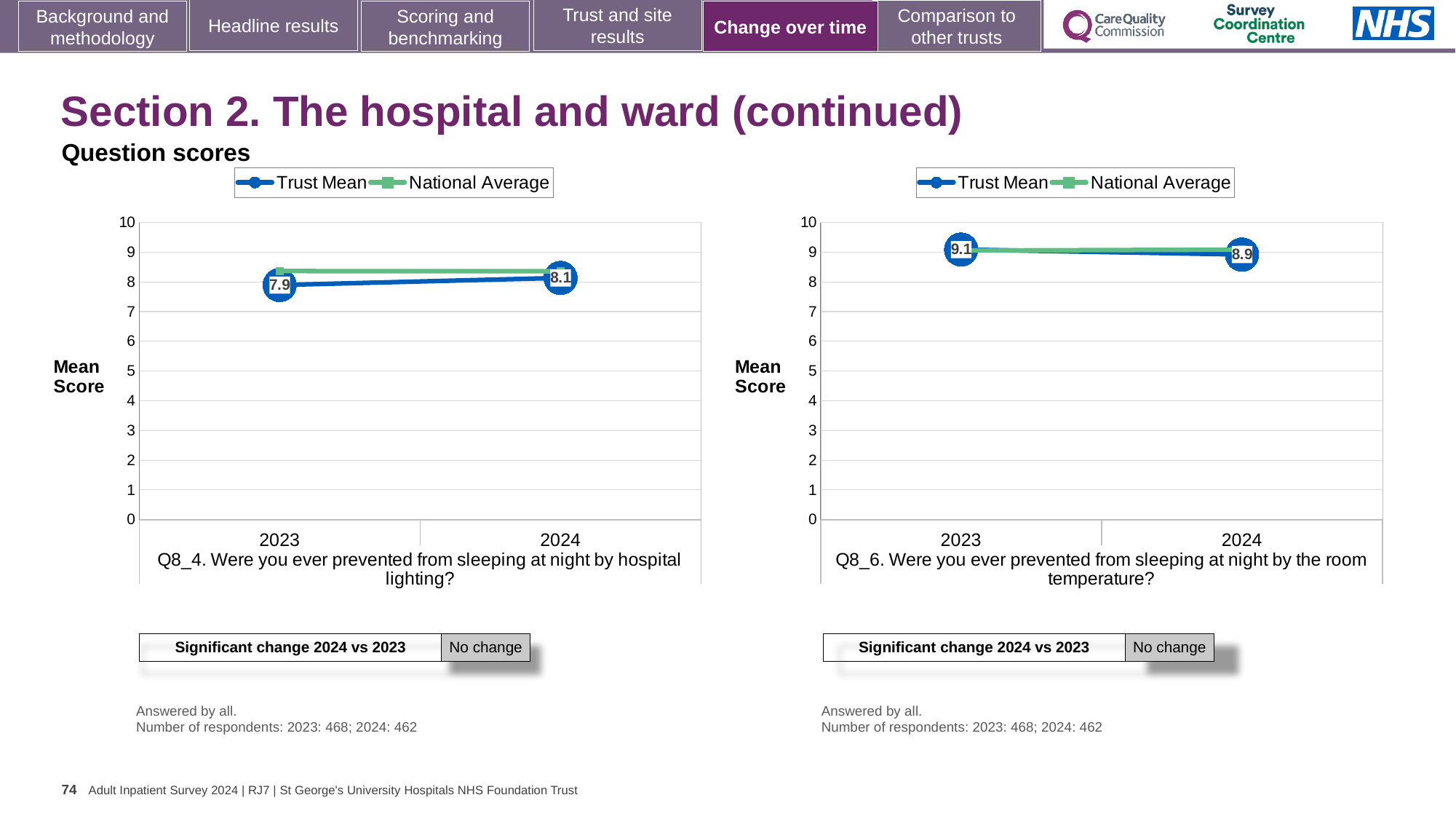
On the Q8_6 room temperature chart, does the Trust Mean rise or fall from 2023 to 2024? fall On the Q8_6 room temperature chart, what is the difference between the Trust Mean in 2023 and 2024? 0.2 On the Q8_4 hospital lighting chart, is the National Average for 2023 greater or less than 8? greater How many series does the legend of the Q8_6 room temperature chart list? 2 On the Q8_4 hospital lighting chart, does the Trust Mean rise or fall from 2023 to 2024? rise On the Q8_4 hospital lighting chart, which is higher in 2023, the Trust Mean or the National Average? National Average On the Q8_4 hospital lighting chart, what is the Trust Mean score for 2024? 8.1 On the Q8_4 hospital lighting chart, what is the Trust Mean score for 2023? 7.9 On the Q8_6 room temperature chart, what is the Trust Mean score for 2023? 9.1 What kind of chart is the Q8_4 hospital lighting chart? line chart On the Q8_6 room temperature chart, what is the Trust Mean score for 2024? 8.9 On the Q8_4 hospital lighting chart, by how much did the Trust Mean change from 2023 to 2024? 0.2